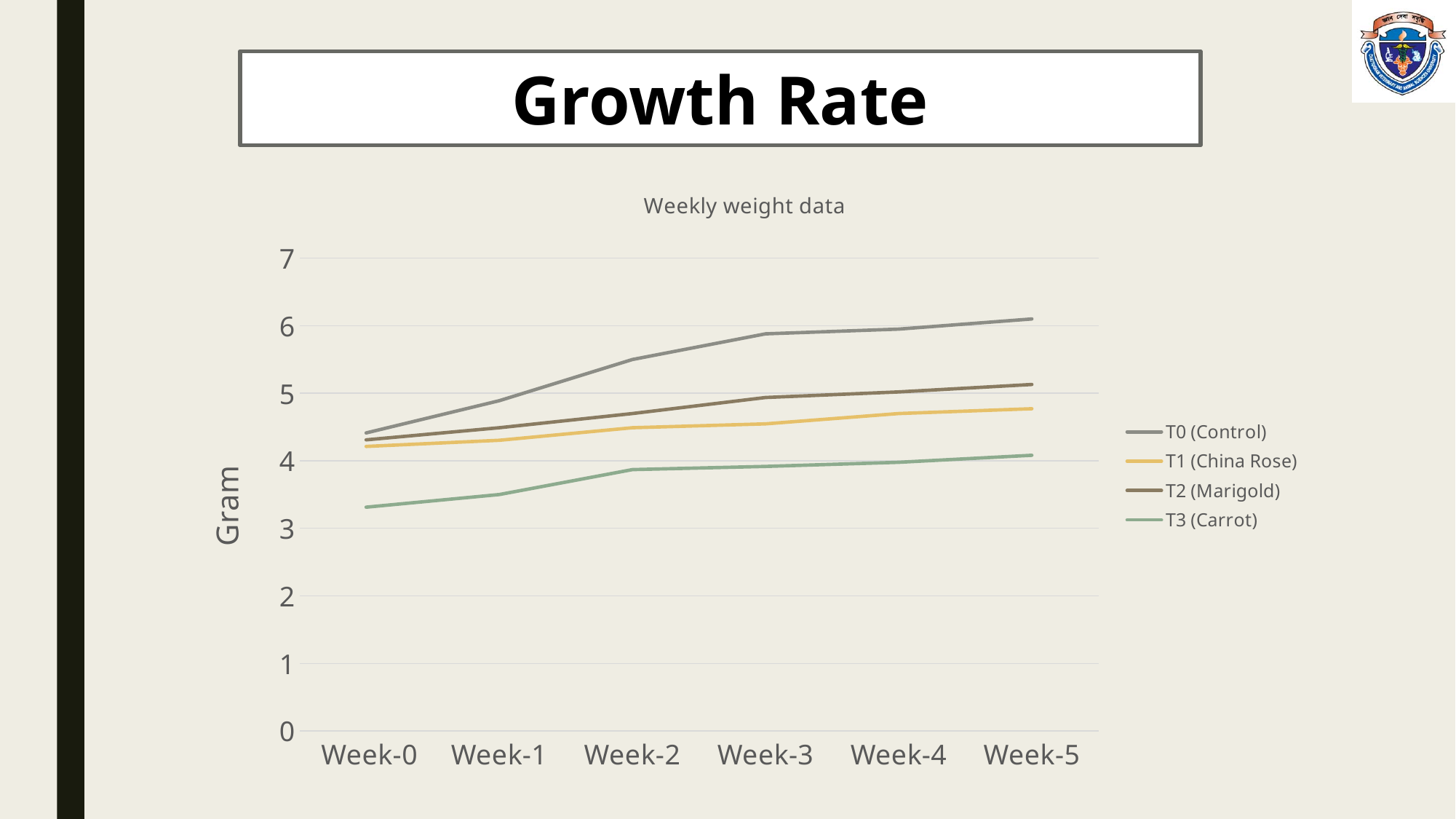
How many weeks are plotted along the x axis? 6 How many series does the legend list? 4 Is the value for T0 (Control) at Week-2 greater or less than 5? greater At Week-3, which is larger: T2 (Marigold) or T1 (China Rose)? T2 (Marigold) What is the label on the y axis? Gram Which series has the highest value at Week-5? T0 (Control) Is the value for T1 (China Rose) at Week-5 greater or less than 5? less Which series has the lowest value at Week-0? T3 (Carrot) Does the T0 (Control) line rise or fall from Week-0 to Week-5? rise What is the title of the chart? Weekly weight data Is the value for T3 (Carrot) at Week-0 greater or less than 4? less What kind of chart is shown on the slide? line chart